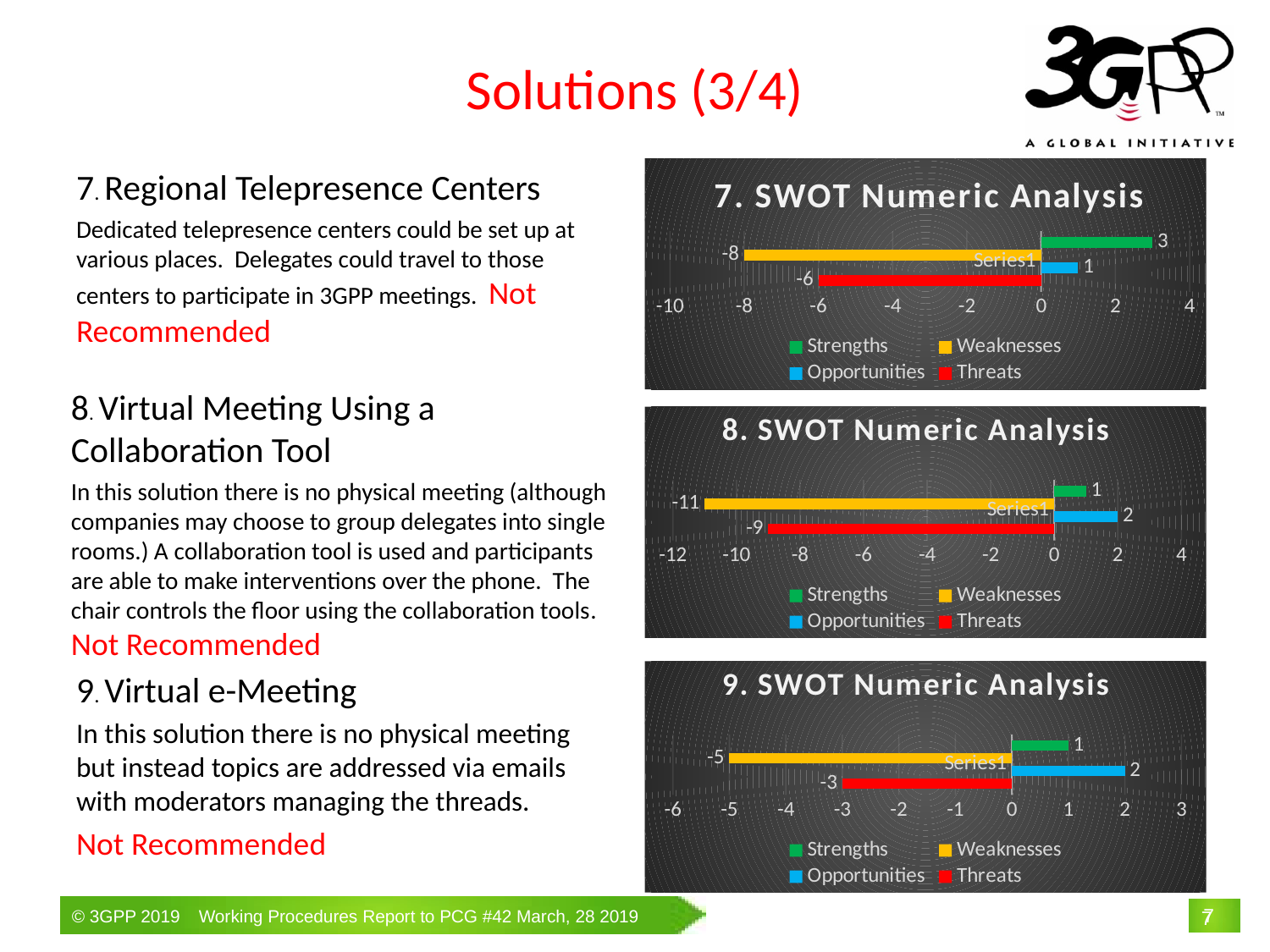
In the chart titled "7. SWOT Numeric Analysis", which series has the highest value? Strengths How many series does the legend list in the chart titled "8. SWOT Numeric Analysis"? 4 In the chart titled "9. SWOT Numeric Analysis", which series has the lowest value? Weaknesses In the chart titled "8. SWOT Numeric Analysis", what is the value for Weaknesses? -11 In the chart titled "7. SWOT Numeric Analysis", what is the value for Strengths? 3 In the chart titled "8. SWOT Numeric Analysis", what is the difference between the Weaknesses value and the Threats value? 2 What kind of chart is the chart titled "9. SWOT Numeric Analysis"? Bar chart In the chart titled "9. SWOT Numeric Analysis", what is the value for Threats? -3 In the chart titled "7. SWOT Numeric Analysis", what is the value for Threats? -6 In the chart titled "9. SWOT Numeric Analysis", which is larger, the value for Strengths or the value for Opportunities? Opportunities In the chart titled "7. SWOT Numeric Analysis", what is the value for Weaknesses? -8 In the chart titled "8. SWOT Numeric Analysis", what is the value for Opportunities? 2